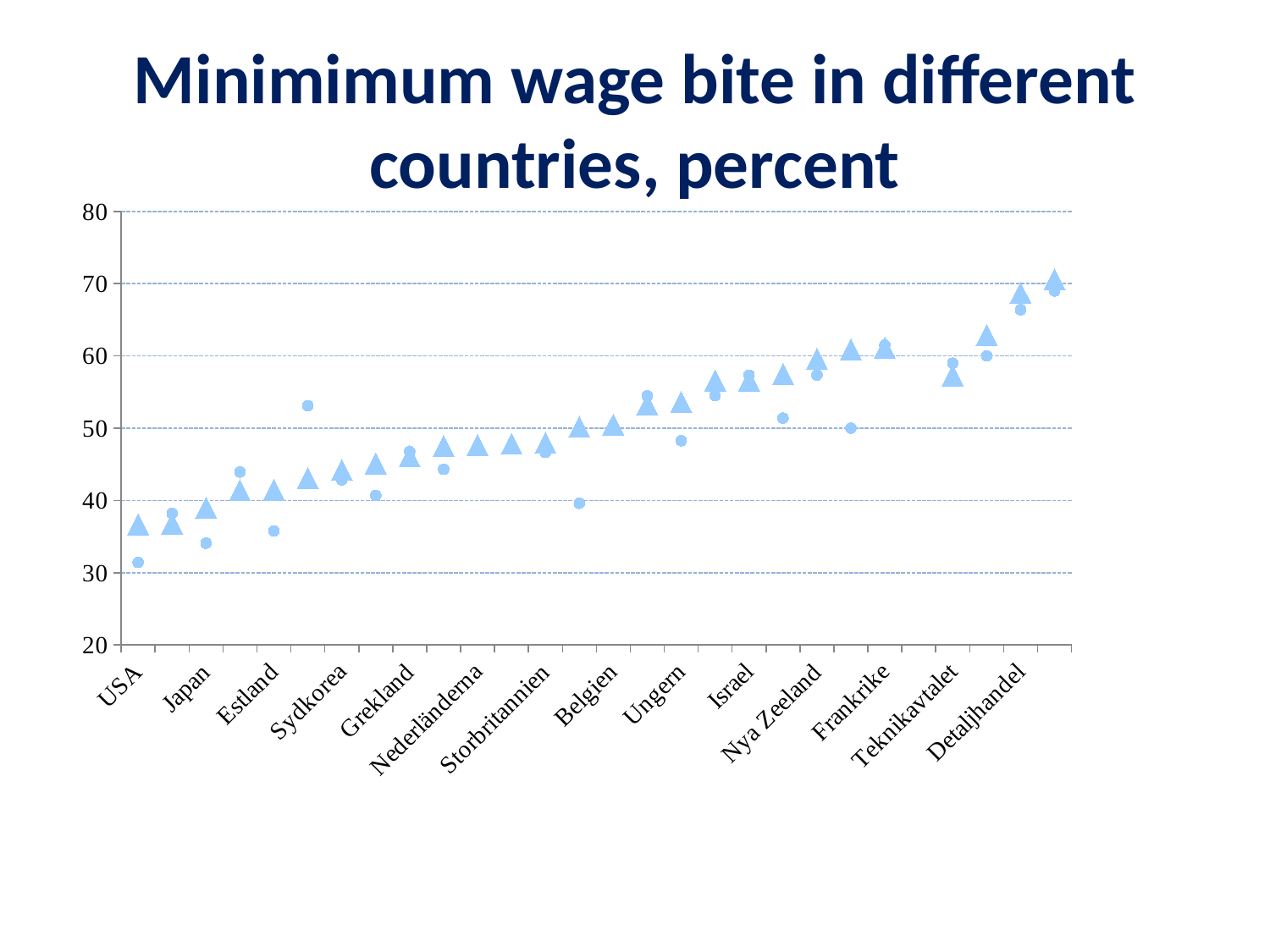
Which labelled category has the highest triangle-marker value? Detaljhandel Is the triangle-marker value for USA greater or less than 40? less Is the circle-marker value for Ungern greater or less than 50? less Is the circle-marker value for Sydkorea greater or less than 50? less Do the triangle-marker values generally rise or fall from USA on the left to Detaljhandel on the right? rise Which has the larger triangle-marker value, USA or Detaljhandel? Detaljhandel Which labelled category has the lowest triangle-marker value? USA What kind of chart is shown on the slide? scatter chart What is the title of the chart? Minimimum wage bite in different countries, percent What is the highest value shown on the vertical axis? 80